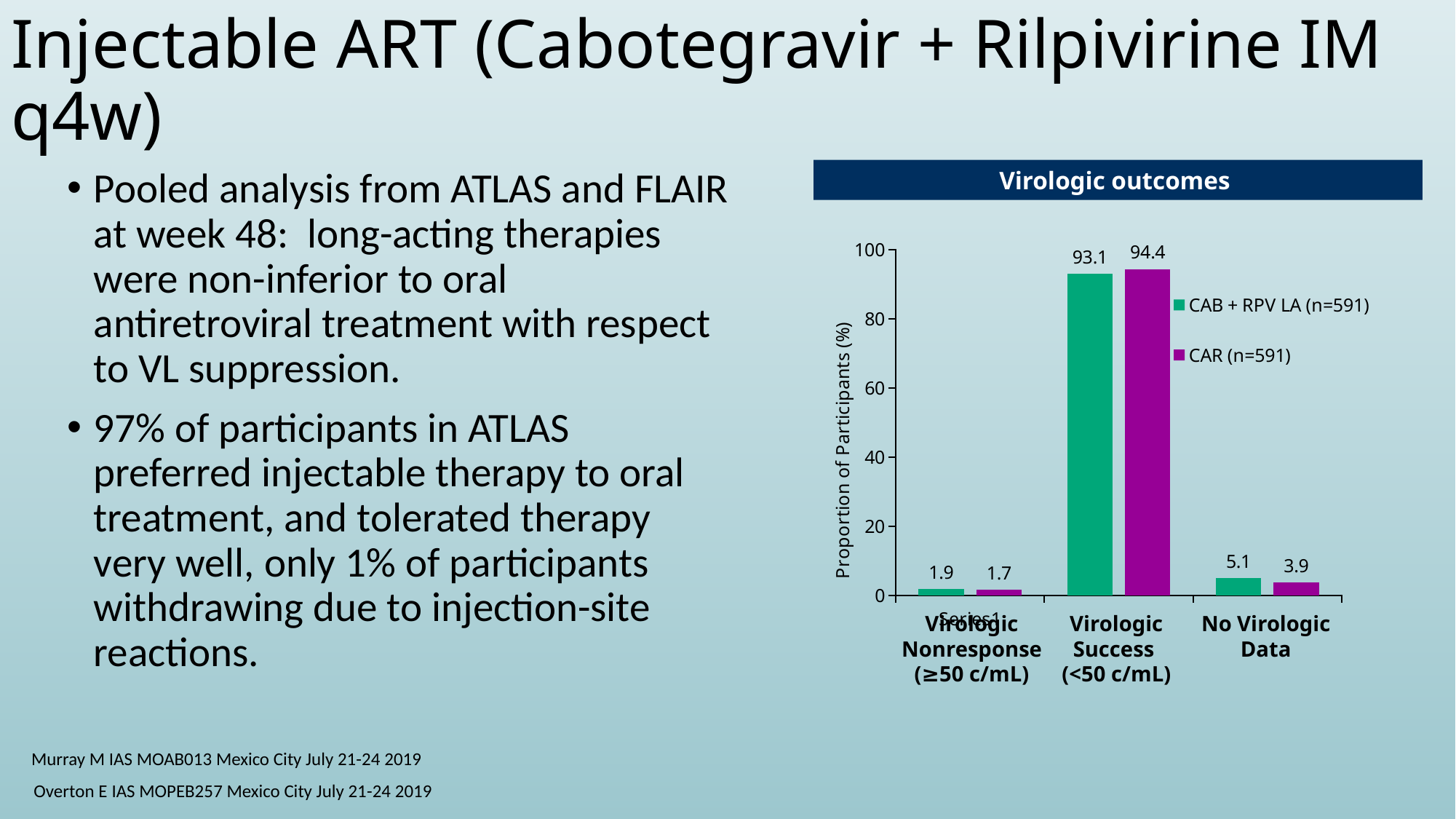
How many series does the chart legend list? 2 What is the value for CAR (n=591) in the No Virologic Data category? 3.9 How many categories are shown on the x axis of the chart? 3 What type of chart is shown on the slide? bar chart What is the value for CAB + RPV LA (n=591) in the Virologic Success (<50 c/mL) category? 93.1 What is the value for CAR (n=591) in the Virologic Success (<50 c/mL) category? 94.4 Is the value for CAR (n=591) in the Virologic Success (<50 c/mL) category greater or less than 80? greater What is the value for CAB + RPV LA (n=591) in the Virologic Nonresponse (≥50 c/mL) category? 1.9 Which category has the lowest value for CAR (n=591)? Virologic Nonresponse (≥50 c/mL) What is the difference between the CAR (n=591) and CAB + RPV LA (n=591) values in the Virologic Success (<50 c/mL) category? 1.3 Which category has the highest value for CAB + RPV LA (n=591)? Virologic Success (<50 c/mL) In the No Virologic Data category, which series has the larger value, CAB + RPV LA (n=591) or CAR (n=591)? CAB + RPV LA (n=591)